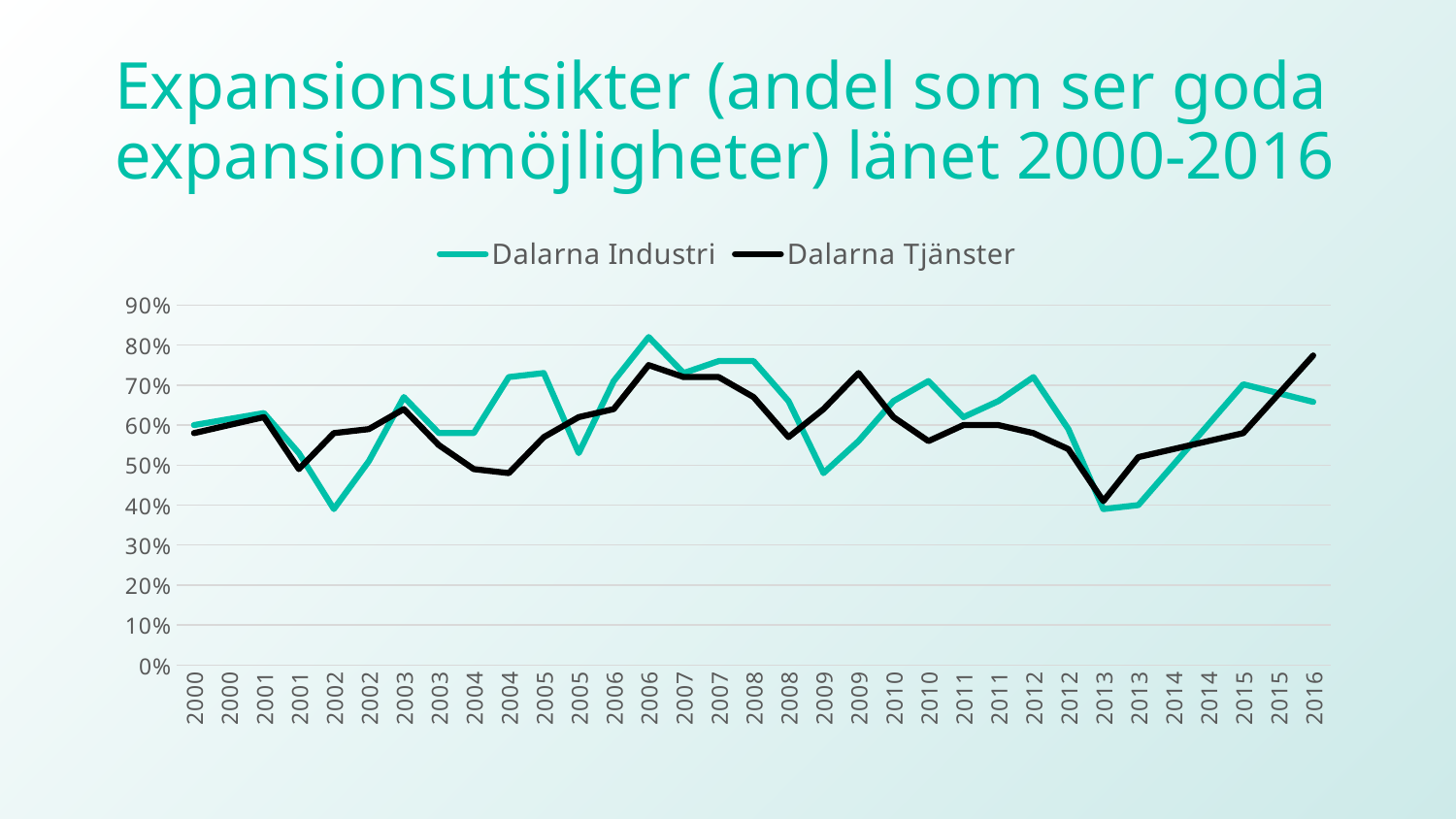
Is the value for Dalarna Industri at the first 2002 point greater or less than 50%? less In which year does Dalarna Tjänster reach its lowest value? 2013 What kind of chart is shown on the slide? Line chart What is the title of the chart? Expansionsutsikter (andel som ser goda expansionsmöjligheter) länet 2000-2016 Is the value for Dalarna Tjänster at 2016 greater or less than 70%? greater Is the value for Dalarna Tjänster at the first 2013 point greater or less than 50%? less At the second 2004 point, which series has the higher value, Dalarna Industri or Dalarna Tjänster? Dalarna Industri In which year does Dalarna Industri reach its highest value? 2006 How many series does the legend list? 2 Which series is drawn in black? Dalarna Tjänster At 2016, which series has the higher value, Dalarna Industri or Dalarna Tjänster? Dalarna Tjänster